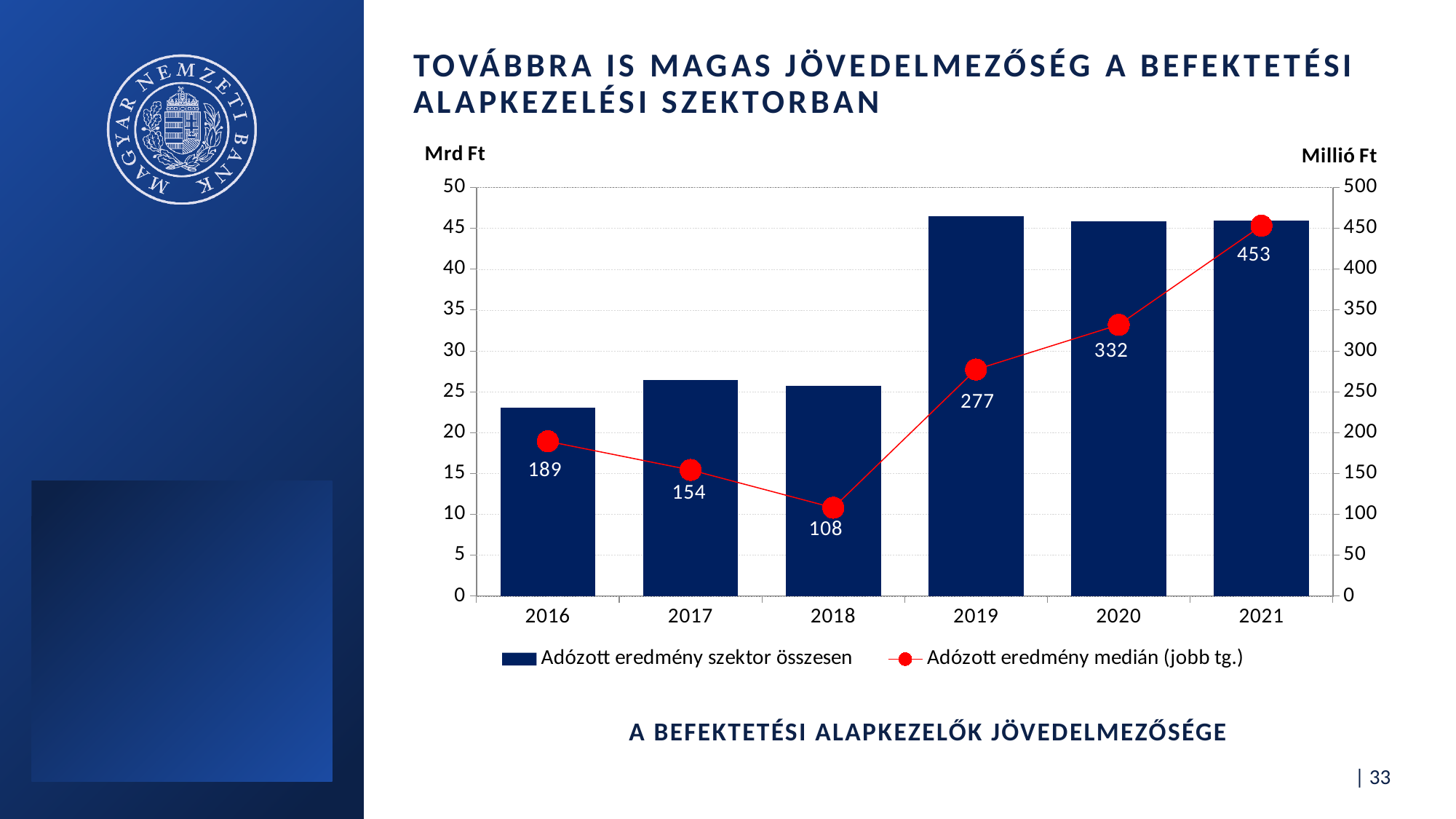
In which year is Adózott eredmény medián (jobb tg.) lowest? 2018 Is the Adózott eredmény szektor összesen bar for 2016 greater or less than 25? less How many years are shown on the x axis? 6 How many series does the legend list? 2 Which year has the larger Adózott eredmény medián (jobb tg.) value, 2017 or 2019? 2019 Is the Adózott eredmény szektor összesen bar for 2019 greater or less than 45? greater What is the value of Adózott eredmény medián (jobb tg.) for 2021? 453 Which year has the lowest Adózott eredmény szektor összesen bar? 2016 What is the difference between the Adózott eredmény medián (jobb tg.) values for 2021 and 2020? 121 In which year is Adózott eredmény medián (jobb tg.) highest? 2021 What is the value of Adózott eredmény medián (jobb tg.) for 2016? 189 What is the value of Adózott eredmény medián (jobb tg.) for 2018? 108